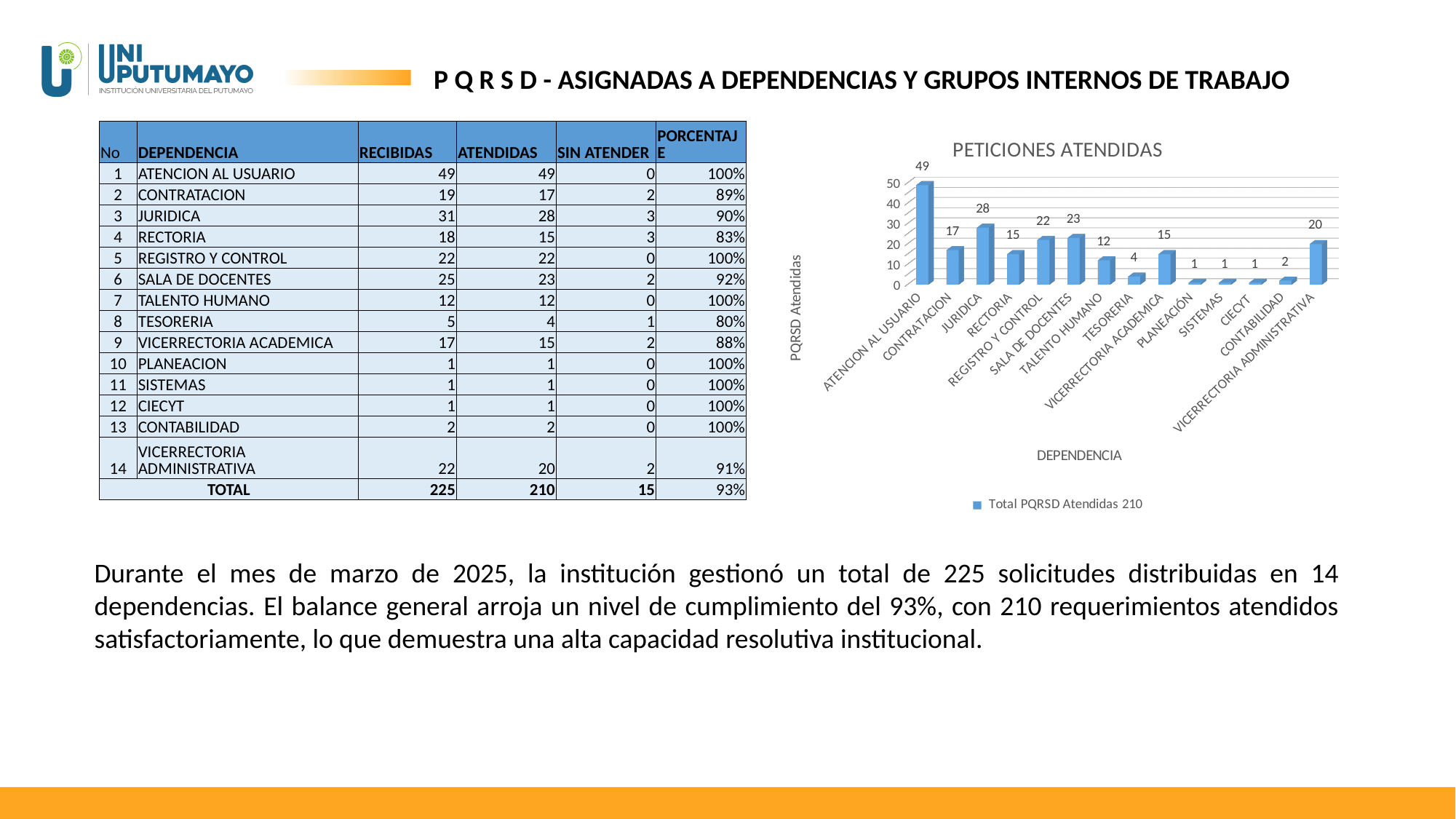
What is the value for ATENCION AL USUARIO in the chart? 49 What is the value for VICERRECTORIA ADMINISTRATIVA in the chart? 20 What is the value for TESORERIA in the chart? 4 Which has a larger value, CONTRATACION or REGISTRO Y CONTROL? REGISTRO Y CONTROL Which category has the highest value in the chart? ATENCION AL USUARIO What is the label of the x axis of the chart? DEPENDENCIA What type of chart is shown on the slide? bar chart How many categories are shown on the x axis of the chart? 14 What is the title of the chart? PETICIONES ATENDIDAS How many series does the chart legend list? 1 What is the difference between the values for SALA DE DOCENTES and TALENTO HUMANO? 11 What is the value for JURIDICA in the chart? 28